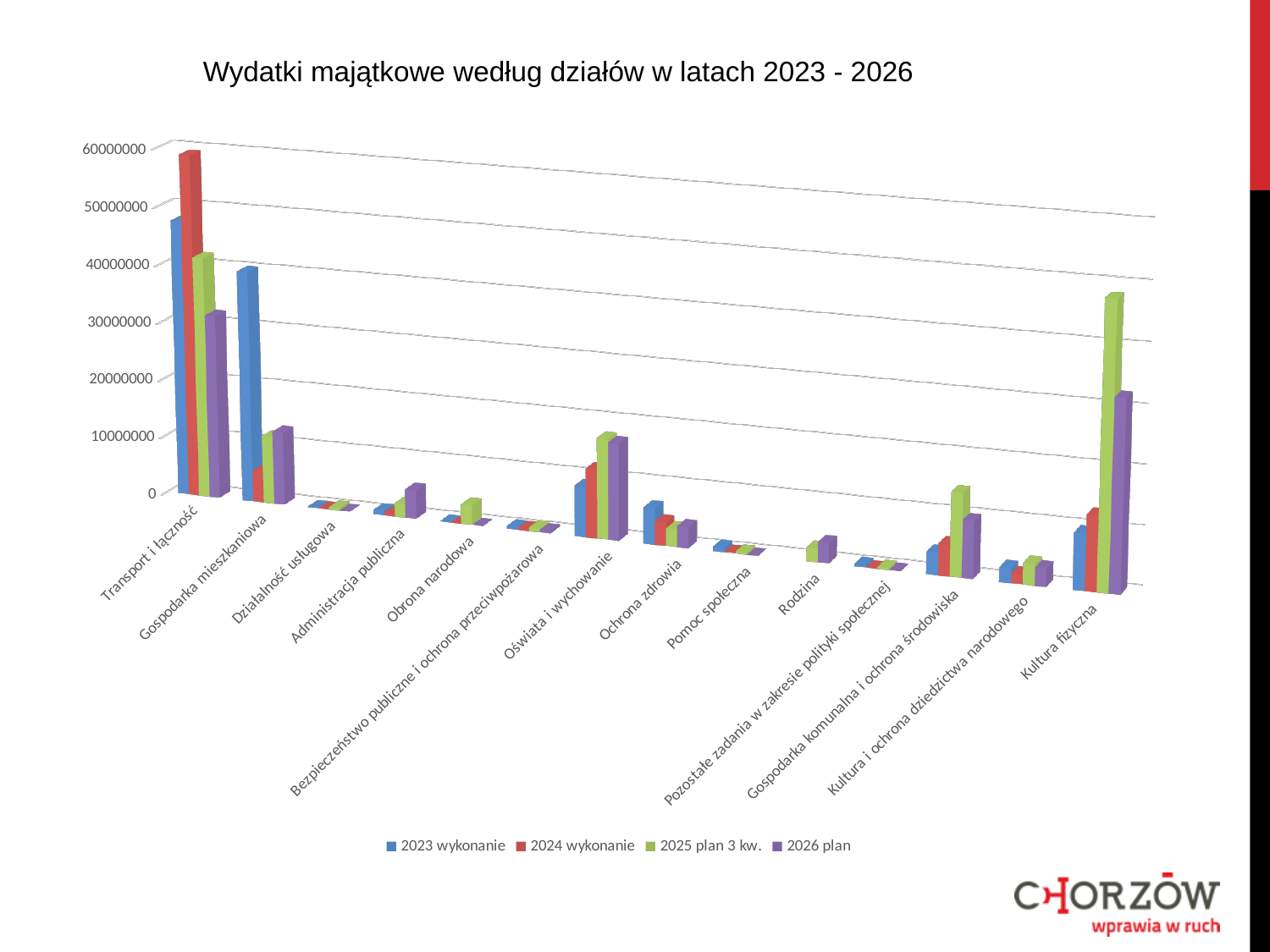
How many series does the legend list? 4 Is the 2024 wykonanie value for Transport i łączność greater or less than 50000000? greater How many categories (działy) are shown on the x axis? 14 What is the title of the chart? Wydatki majątkowe według działów w latach 2023 - 2026 For Gospodarka mieszkaniowa, which series has the highest value? 2023 wykonanie What kind of chart is shown on the slide? bar chart For Kultura fizyczna, which is larger: the 2025 plan 3 kw. value or the 2026 plan value? 2025 plan 3 kw. Is the 2025 plan 3 kw. value for Kultura fizyczna greater or less than 20000000? greater Which series is shown in green in the legend? 2025 plan 3 kw. For Transport i łączność, which series has the highest value? 2024 wykonanie Which category has the highest bar in the chart? Transport i łączność Is the 2023 wykonanie value for Transport i łączność greater or less than 30000000? greater